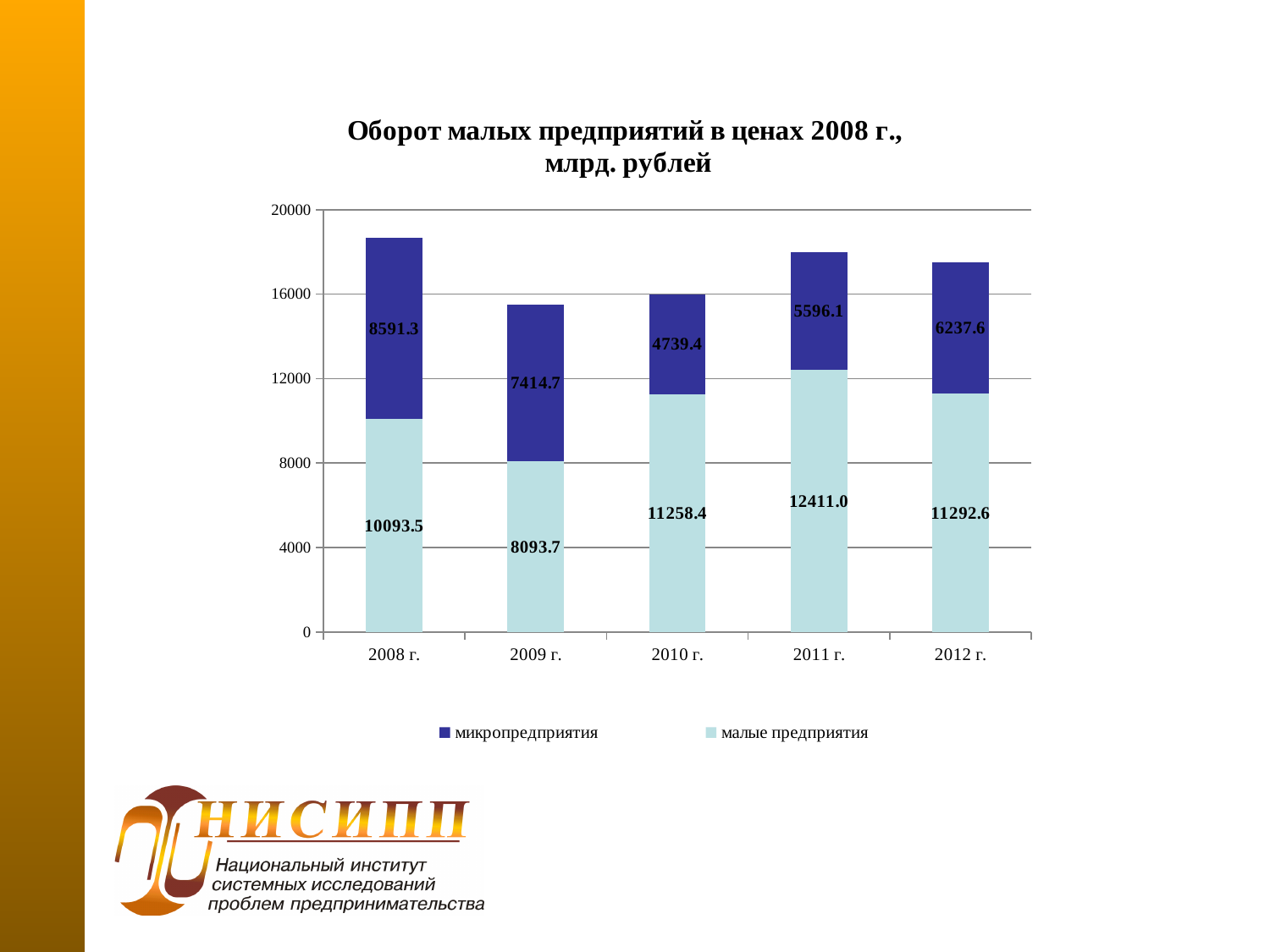
What kind of chart is shown on the slide? stacked bar chart What is the value for малые предприятия in 2009 г.? 8093.7 How many series does the legend list? 2 In which year is the value for малые предприятия highest? 2011 г. What is the difference between the малые предприятия values for 2011 г. and 2008 г.? 2317.5 What is the value for малые предприятия in 2011 г.? 12411.0 How many years are shown on the x axis? 5 What is the total of the stacked bar for 2012 г.? 17530.2 Which is larger: микропредприятия in 2008 г. or микропредприятия in 2012 г.? 2008 г. Is the total height of the 2009 г. bar greater or less than 16000? less In which year is the value for микропредприятия lowest? 2010 г. What is the value for микропредприятия in 2010 г.? 4739.4